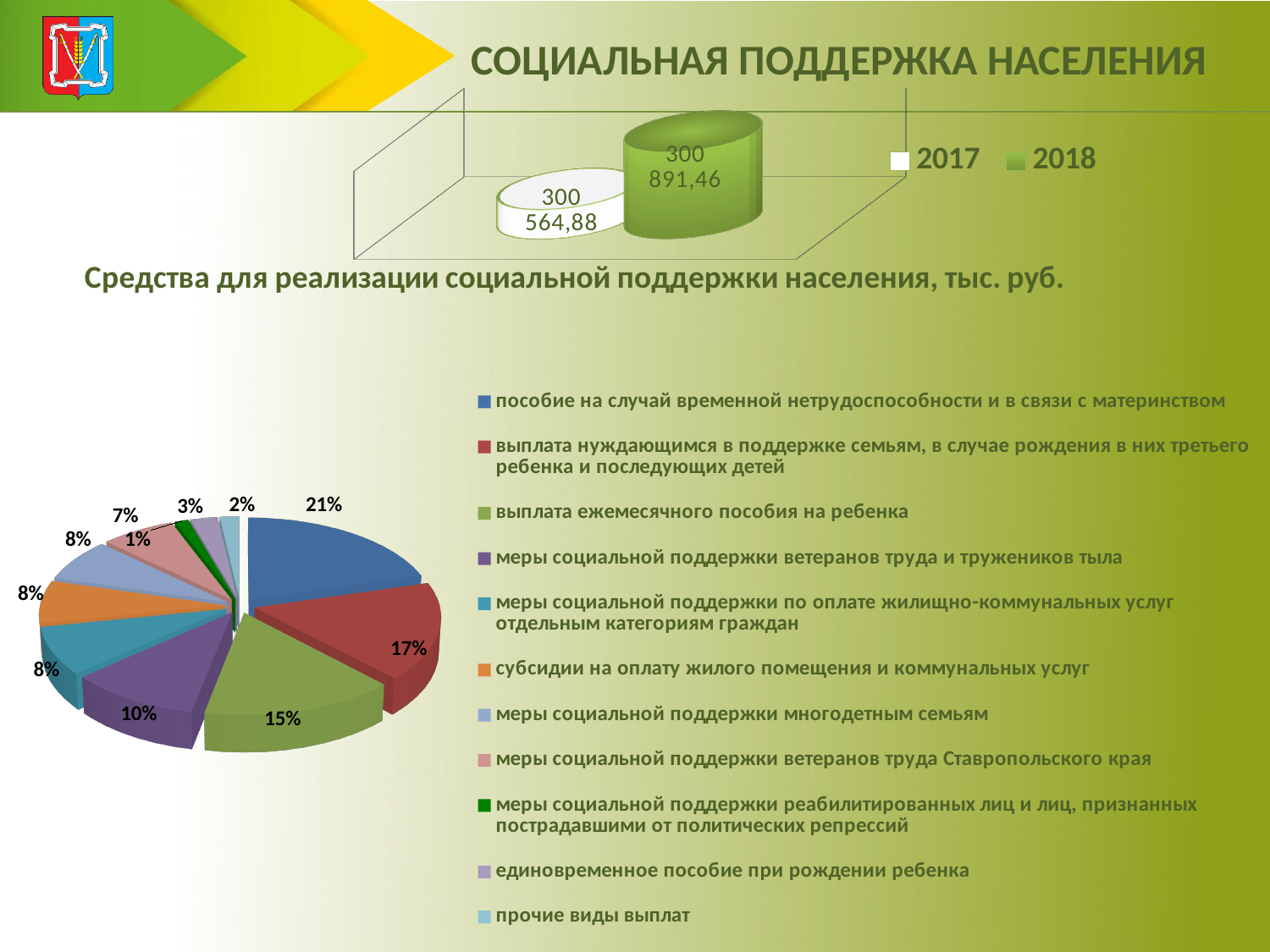
In the bottom pie chart, what share is shown for 'меры социальной поддержки ветеранов труда и тружеников тыла'? 10% In the bottom pie chart, what share is shown for 'пособие на случай временной нетрудоспособности и в связи с материнством'? 21% In the top chart (Средства для реализации социальной поддержки населения, тыс. руб.), what is the value for 2017? 300 564,88 How many series does the legend of the top chart list? 2 In the top chart (Средства для реализации социальной поддержки населения, тыс. руб.), what is the value for 2018? 300 891,46 In the bottom pie chart, what share is shown for 'выплата ежемесячного пособия на ребенка'? 15% In the top chart, by how much does the 2018 value exceed the 2017 value? 326,58 What kind of chart is the bottom chart on the slide? Pie chart How many categories does the legend of the bottom pie chart list? 11 In the bottom pie chart, which category has the largest share? пособие на случай временной нетрудоспособности и в связи с материнством In the bottom pie chart, which category has the smallest share? меры социальной поддержки реабилитированных лиц и лиц, признанных пострадавшими от политических репрессий In the top chart, which year has the larger value, 2017 or 2018? 2018